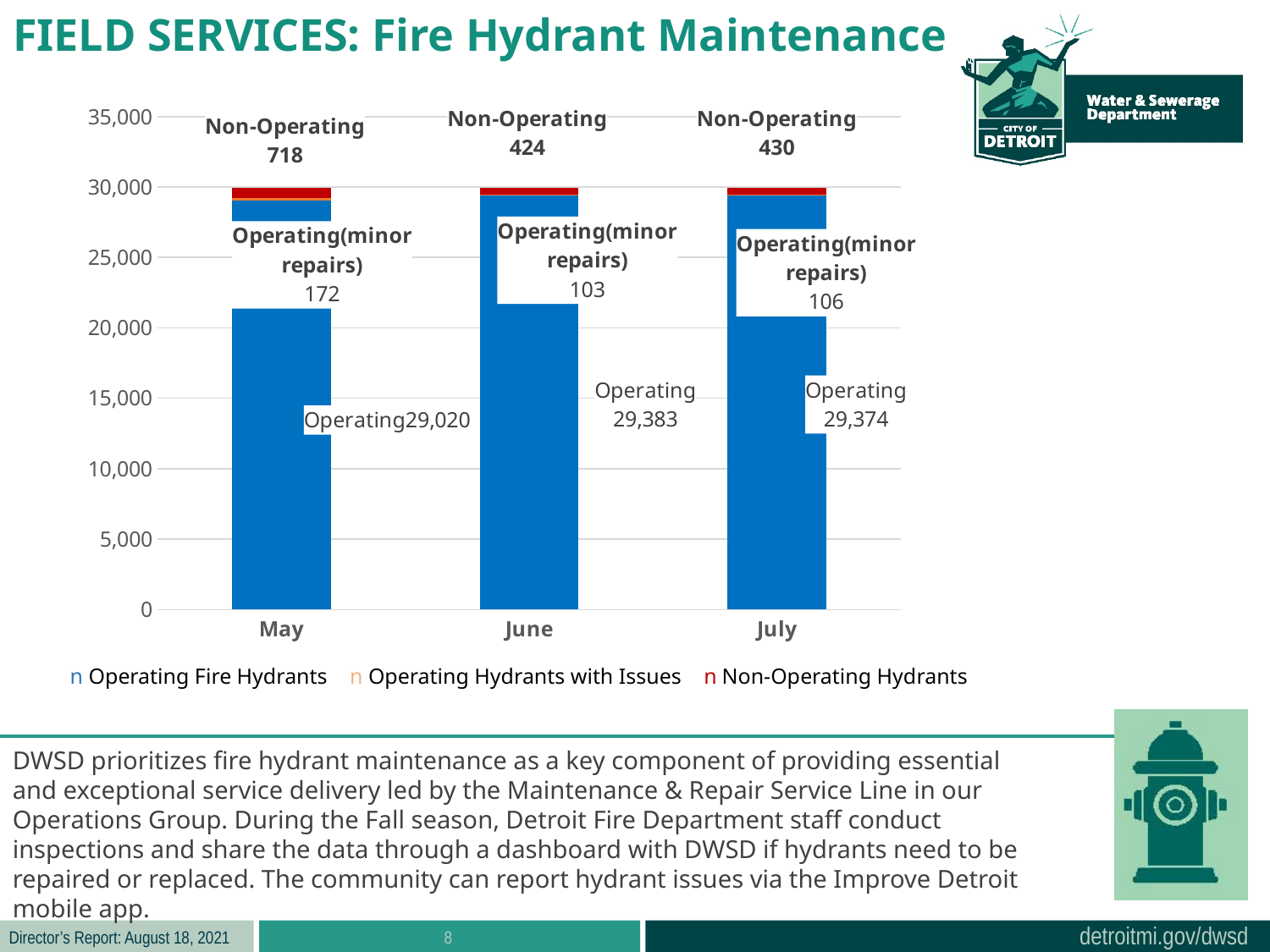
Is the Operating fire hydrants value for May greater or less than 25,000? greater How many months are shown on the x axis of the chart? 3 What is the total of the stacked bar for May? 29,910 How many series does the legend list? 3 What kind of chart is shown on the slide? Stacked bar chart What is the number of Operating fire hydrants in May? 29,020 Which month has the highest number of Non-Operating hydrants? May What is the difference between the Non-Operating hydrant counts for May and June? 294 What is the Operating (minor repairs) value for July? 106 Which is larger, the Operating count for June or for July? June How many Non-Operating hydrants are shown for June? 424 Which month has the lowest number of Operating fire hydrants? May